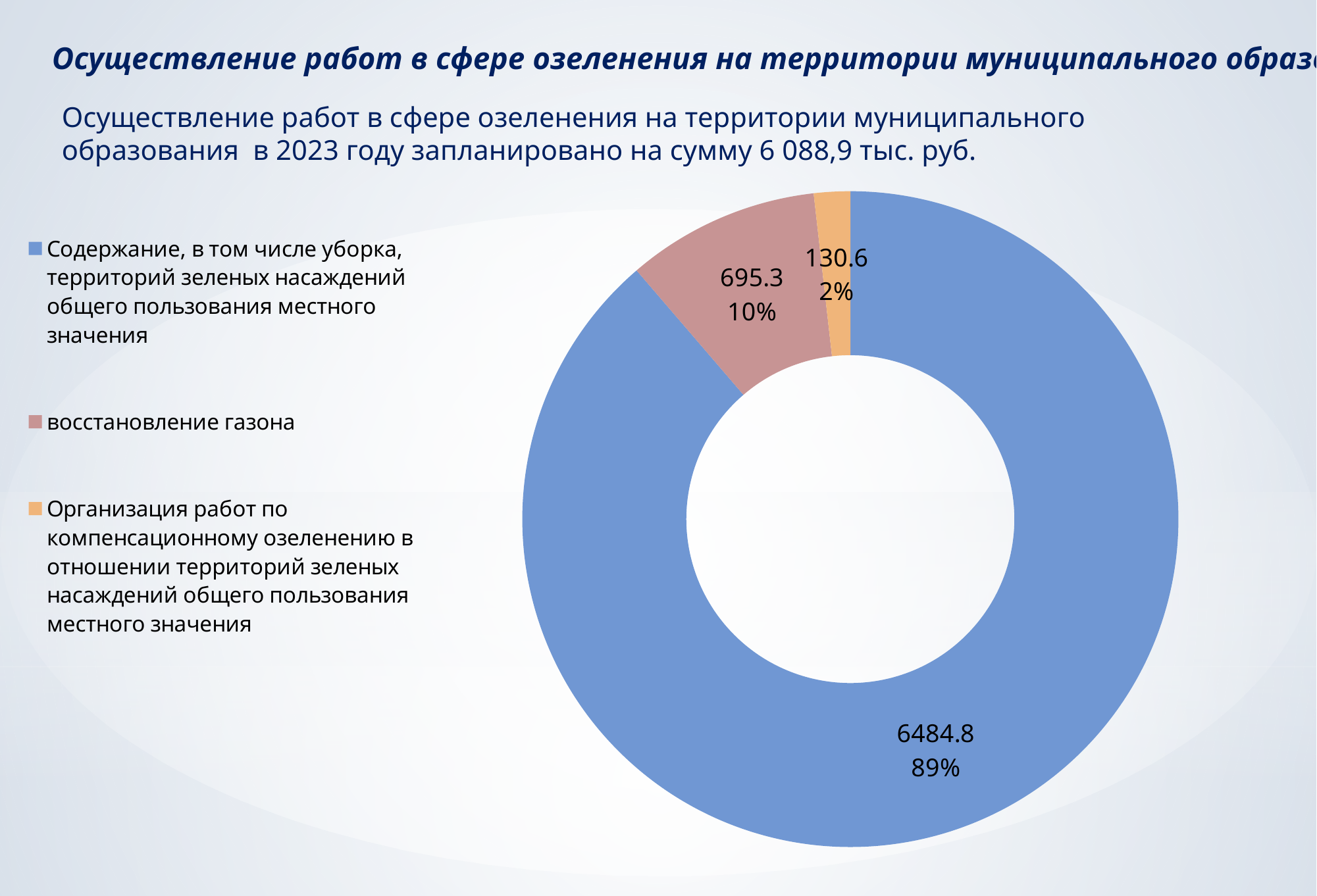
Which category has the largest slice in the chart? Содержание, в том числе уборка, территорий зеленых насаждений общего пользования местного значения What kind of chart is shown on the slide? doughnut chart How many categories does the chart show? 3 What percentage share does the slice "восстановление газона" have? 10% What value is shown for the slice "восстановление газона"? 695.3 Which is larger: the value for "восстановление газона" or the value for "Организация работ по компенсационному озеленению..."? восстановление газона What percentage share does the slice "Содержание, в том числе уборка, территорий зеленых насаждений общего пользования местного значения" have? 89% What percentage share does the slice "Организация работ по компенсационному озеленению..." have? 2% What value is shown for the slice "Содержание, в том числе уборка, территорий зеленых насаждений общего пользования местного значения"? 6484.8 What is the difference between the values for "восстановление газона" and "Организация работ по компенсационному озеленению..."? 564.7 What value is shown for the slice "Организация работ по компенсационному озеленению в отношении территорий зеленых насаждений общего пользования местного значения"? 130.6 Which category has the smallest slice in the chart? Организация работ по компенсационному озеленению в отношении территорий зеленых насаждений общего пользования местного значения